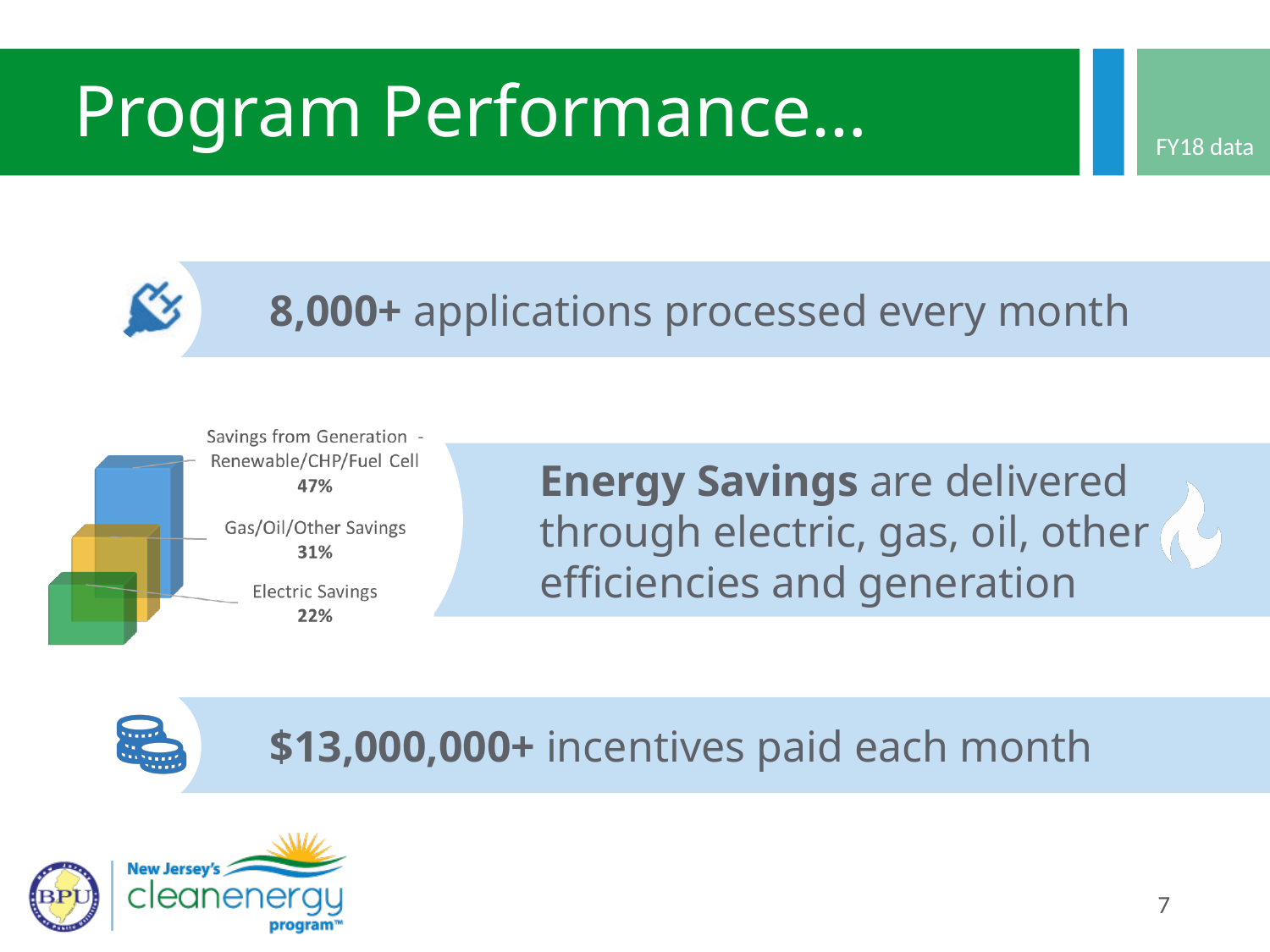
Which category has the smallest share of energy savings? Electric Savings What colour is the bar for Electric Savings? green Which is larger, Gas/Oil/Other Savings or Electric Savings? Gas/Oil/Other Savings What is the difference in percentage points between Savings from Generation - Renewable/CHP/Fuel Cell and Electric Savings? 25 What is the difference in percentage points between Gas/Oil/Other Savings and Electric Savings? 9 Which category has the largest share of energy savings? Savings from Generation - Renewable/CHP/Fuel Cell What is the total of the three energy savings percentages shown in the chart? 100% What percentage of energy savings comes from Savings from Generation - Renewable/CHP/Fuel Cell? 47% What percentage of energy savings comes from Electric Savings? 22% How many categories are shown in the energy savings chart? 3 What percentage of energy savings comes from Gas/Oil/Other Savings? 31% What kind of chart is used to show the energy savings breakdown? bar chart